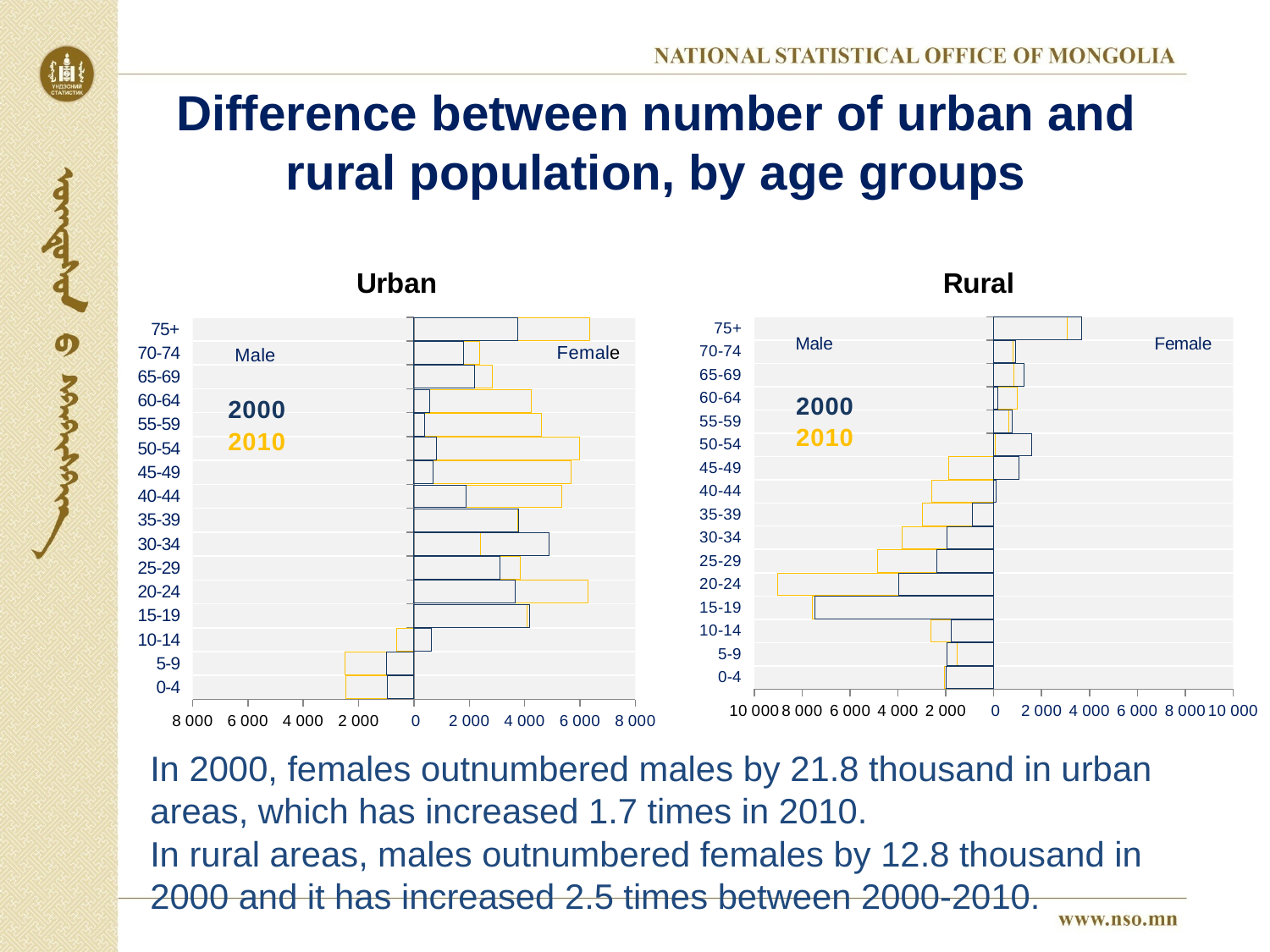
How many years (series) are plotted on the Urban chart? 2 On the Rural chart, which age group has the largest male surplus in 2000? 15-19 On the Urban chart, is the 2010 value for the 75+ age group greater or less than 6 000? greater On the Rural chart, which age group has the largest male surplus in 2010? 20-24 How many age groups are shown on the Rural chart? 16 On the Urban chart, which colour represents 2010? yellow On the Rural chart, is the 2010 value for the 75+ age group greater or less than 2 000? greater On the Urban chart, is the 2010 value for the 5-9 age group on the male side or the female side? male side On the Rural chart, is the 2000 value for the 20-24 age group on the male side greater or less than 2 000? greater What is the maximum value shown on the horizontal axis of the Rural chart? 10 000 What kind of chart is the Urban chart? bar chart